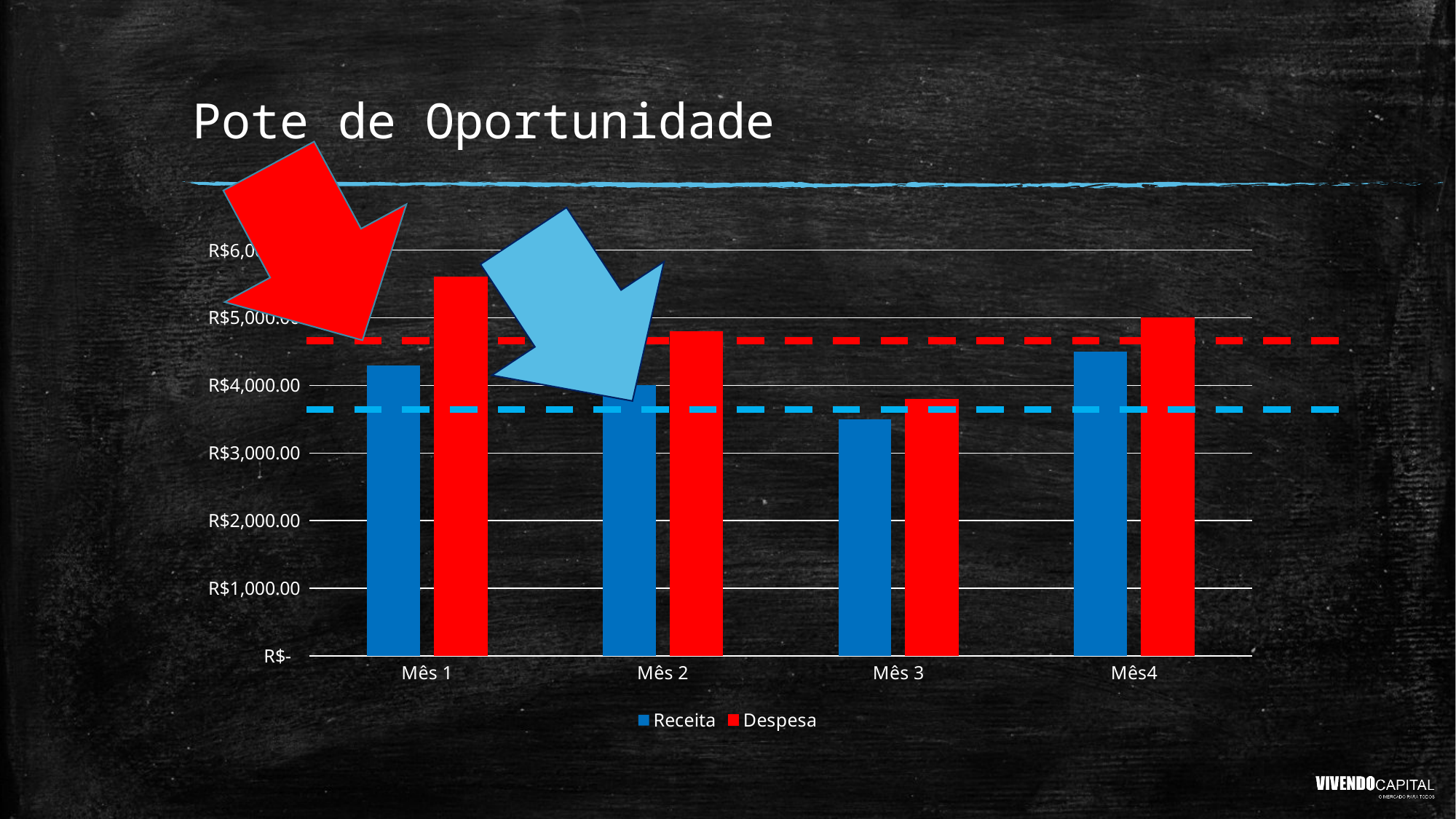
Is the Despesa value for Mês 1 greater or less than R$5,000.00? greater Which colour represents the Receita series in the chart? blue Is the Receita value for Mês 3 greater or less than R$4,000.00? less Is the Receita value for Mês4 greater or less than R$4,000.00? greater How many months (categories) are shown on the x axis of the chart? 4 What kind of chart is shown on the slide? bar chart Which month has the highest Despesa value? Mês 1 Which month has the lowest Receita value? Mês 3 How many series does the chart legend list? 2 In Mês 1, which is larger, Receita or Despesa? Despesa What is the title of the slide containing the chart? Pote de Oportunidade